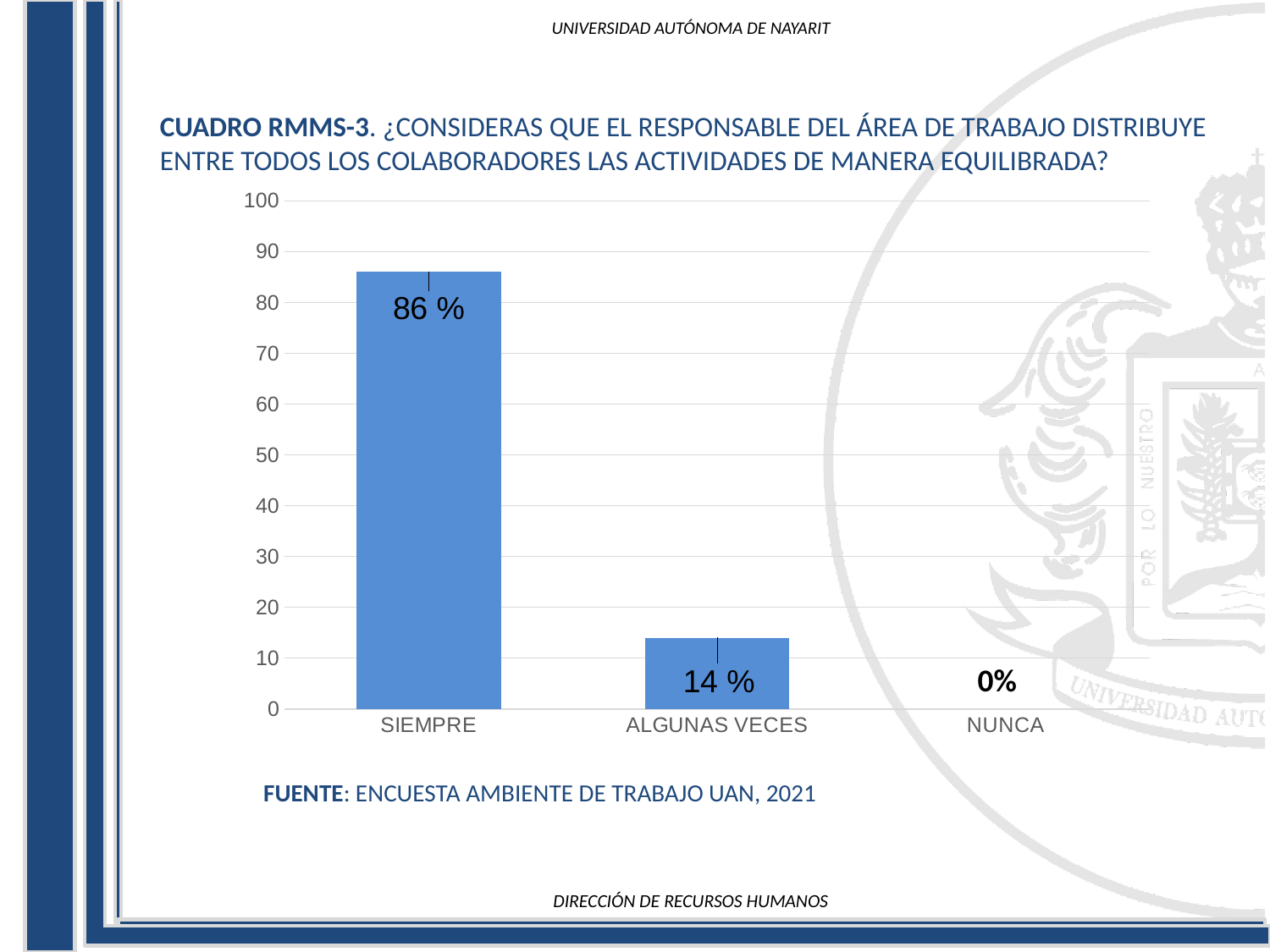
What is the value for ALGUNAS VECES? 14 % How many categories are shown on the x axis? 3 What kind of chart is shown on the slide? Bar chart Is the value for ALGUNAS VECES greater or less than 20? less What is the difference between the values for SIEMPRE and ALGUNAS VECES? 72 % What source is cited below the chart? ENCUESTA AMBIENTE DE TRABAJO UAN, 2021 What is the value for NUNCA? 0% Which category has the lowest value? NUNCA Which category has the highest value? SIEMPRE What is the value for SIEMPRE? 86 % Which is larger, the value for SIEMPRE or the value for ALGUNAS VECES? SIEMPRE Is the value for SIEMPRE greater or less than 80? greater